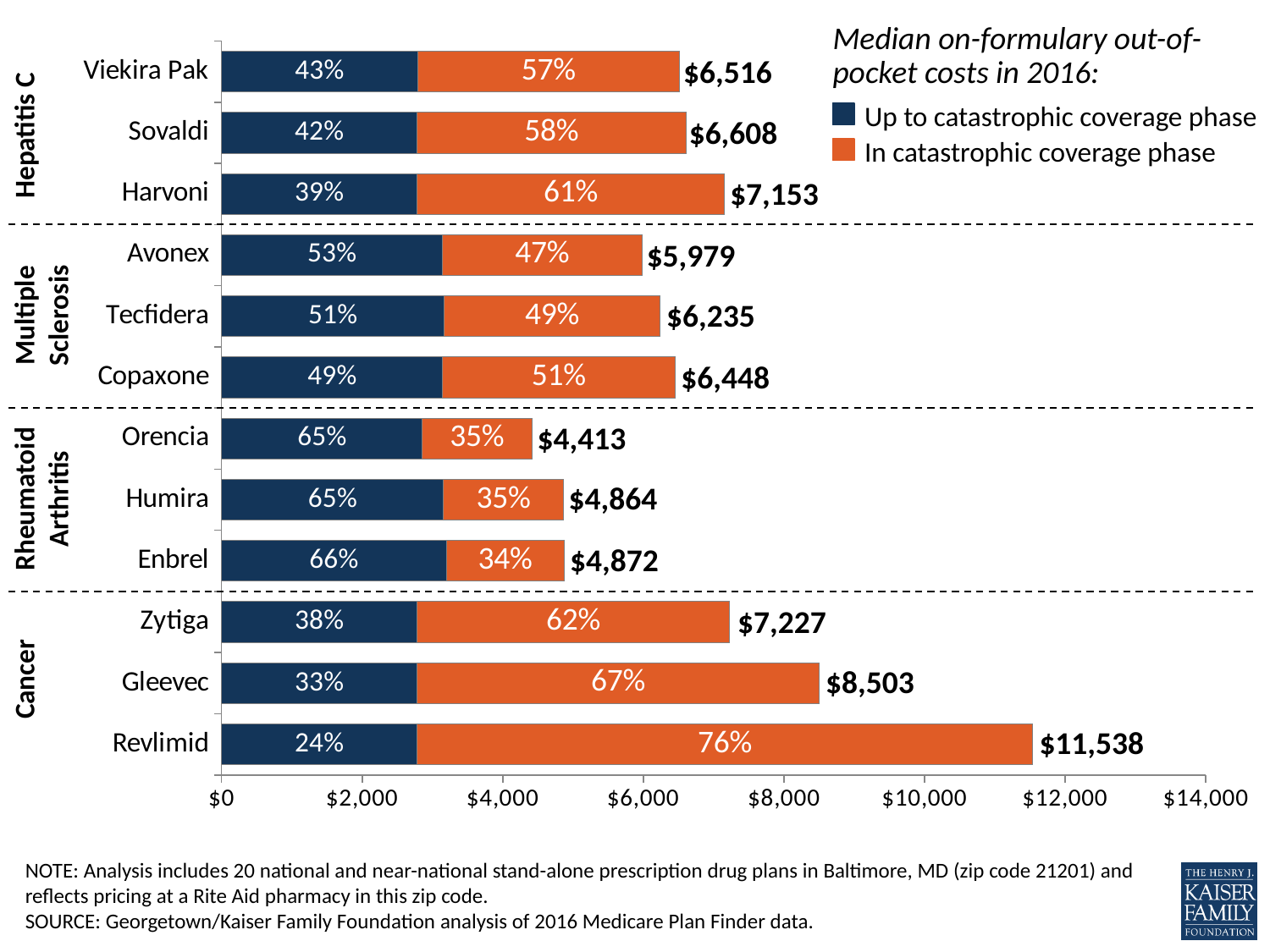
What percentage of Orencia's out-of-pocket cost is up to the catastrophic coverage phase? 65% How many series does the legend list? 2 What kind of chart is shown on the slide? Stacked bar chart Which drug has the lowest median out-of-pocket cost? Orencia Is the median out-of-pocket cost for Copaxone greater or less than $6,000? greater What percentage of Harvoni's out-of-pocket cost is in the catastrophic coverage phase? 61% What is the median on-formulary out-of-pocket cost in 2016 for Revlimid? $11,538 Which drug has the highest median out-of-pocket cost? Revlimid What is the difference in median out-of-pocket cost between Gleevec and Zytiga? $1,276 Which colour represents the 'In catastrophic coverage phase' series? Orange Which has a higher median out-of-pocket cost, Sovaldi or Viekira Pak? Sovaldi How many drugs are shown in the chart? 12